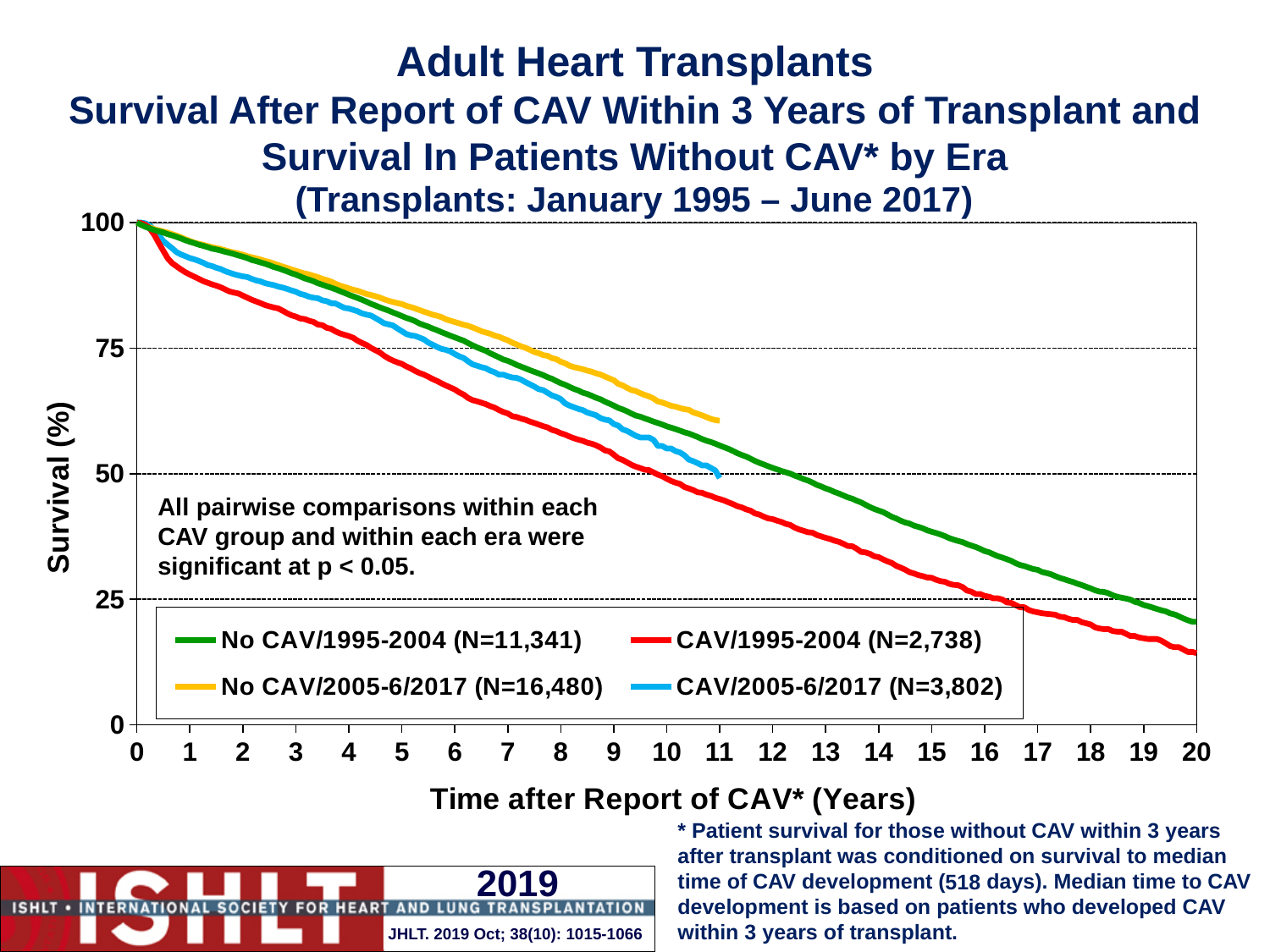
What is the label of the y axis? Survival (%) Is the survival value for CAV/1995-2004 at 5 years greater or less than 50? greater At 5 years, which series has higher survival: No CAV/2005-6/2017 or CAV/2005-6/2017? No CAV/2005-6/2017 Is the survival value for No CAV/2005-6/2017 at 11 years greater or less than 50? greater Which series has the lowest survival at 10 years? CAV/1995-2004 What is the N shown in the legend for the CAV/1995-2004 series? 2,738 Is the survival value for No CAV/1995-2004 at 15 years greater or less than 25? greater Does survival for the CAV/1995-2004 series rise or fall as time after report of CAV increases? fall How many series does the legend list? 4 At 10 years, which series has higher survival: No CAV/1995-2004 or CAV/1995-2004? No CAV/1995-2004 What kind of chart is shown on the slide? line chart